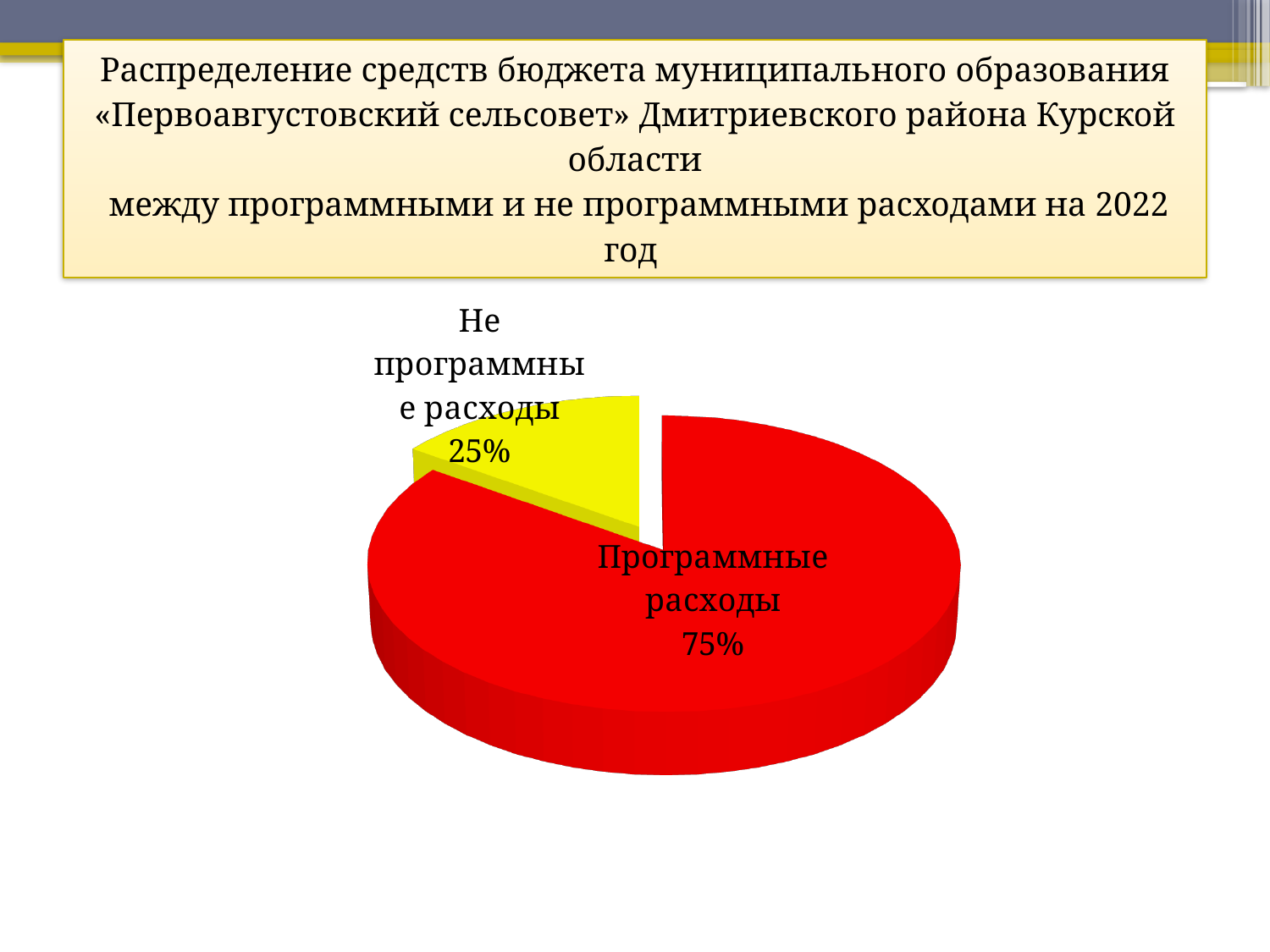
What colour is the "Программные расходы" slice? Red What share of the pie is labelled "Не программные расходы"? 25% What is the difference in percentage points between the "Программные расходы" and "Не программные расходы" slices? 50 Which slice of the pie is the smallest? Не программные расходы Which slice of the pie is the largest? Программные расходы What share of the pie is labelled "Программные расходы"? 75% What kind of chart is shown on the slide? Pie chart Which is larger: the share for "Программные расходы" or for "Не программные расходы"? Программные расходы What colour is the "Не программные расходы" slice? Yellow What is the combined share of the two slices in the pie chart? 100% How many slices does the pie chart have? 2